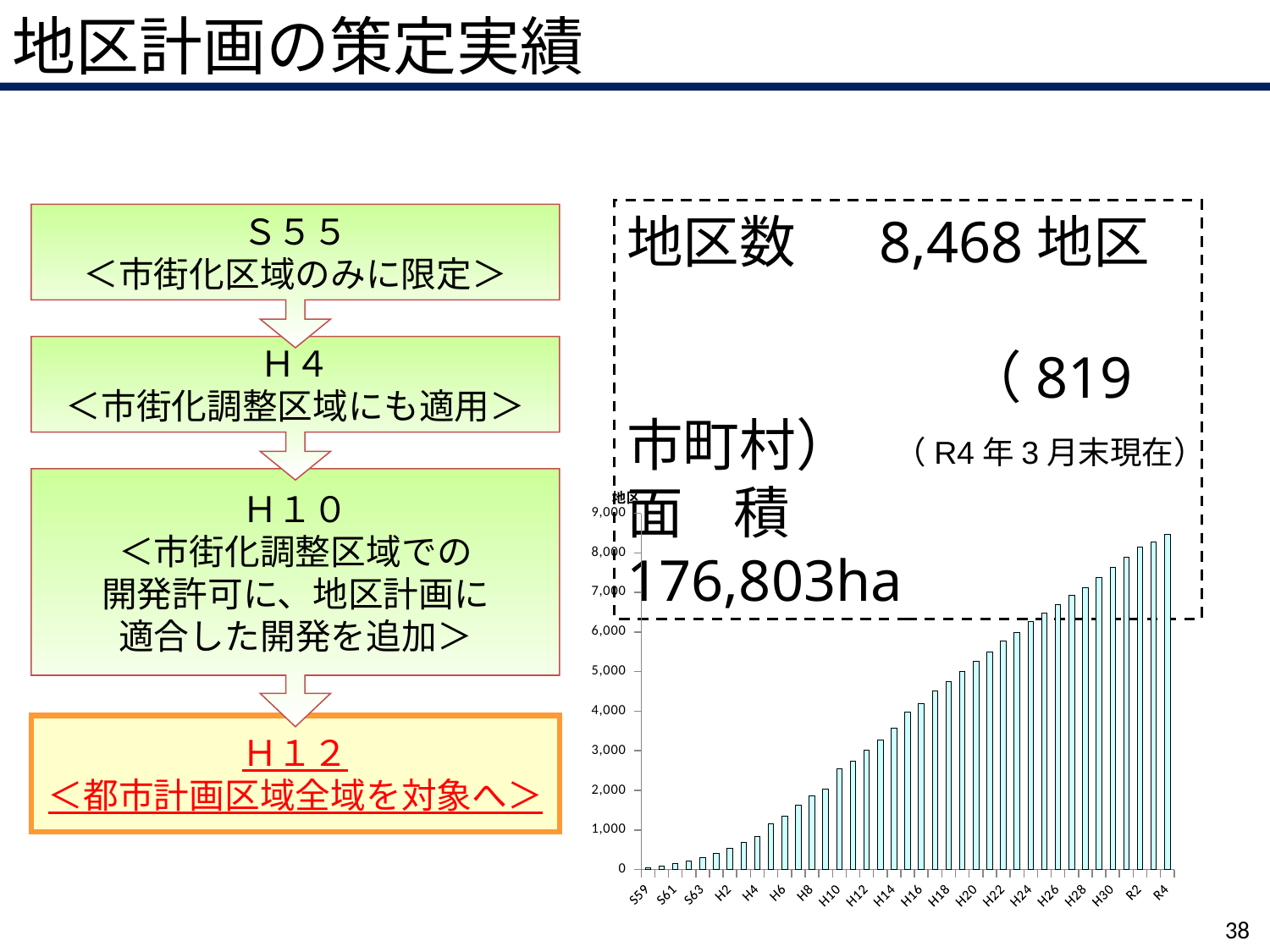
Which year has the shortest bar in the chart? S59 Do the bar values rise or fall from S59 to R4? rise Is the value for R4 greater or less than 8,000? greater What kind of chart is shown on the right side of the slide? bar chart Which is larger, the value for H20 or the value for H10? H20 Is the value for H30 greater or less than 7,000? greater Is the value for H2 greater or less than 1,000? less What is the highest tick value shown on the vertical axis? 9,000 What unit label is printed at the top of the vertical axis? 地区 Which year has the tallest bar in the chart? R4